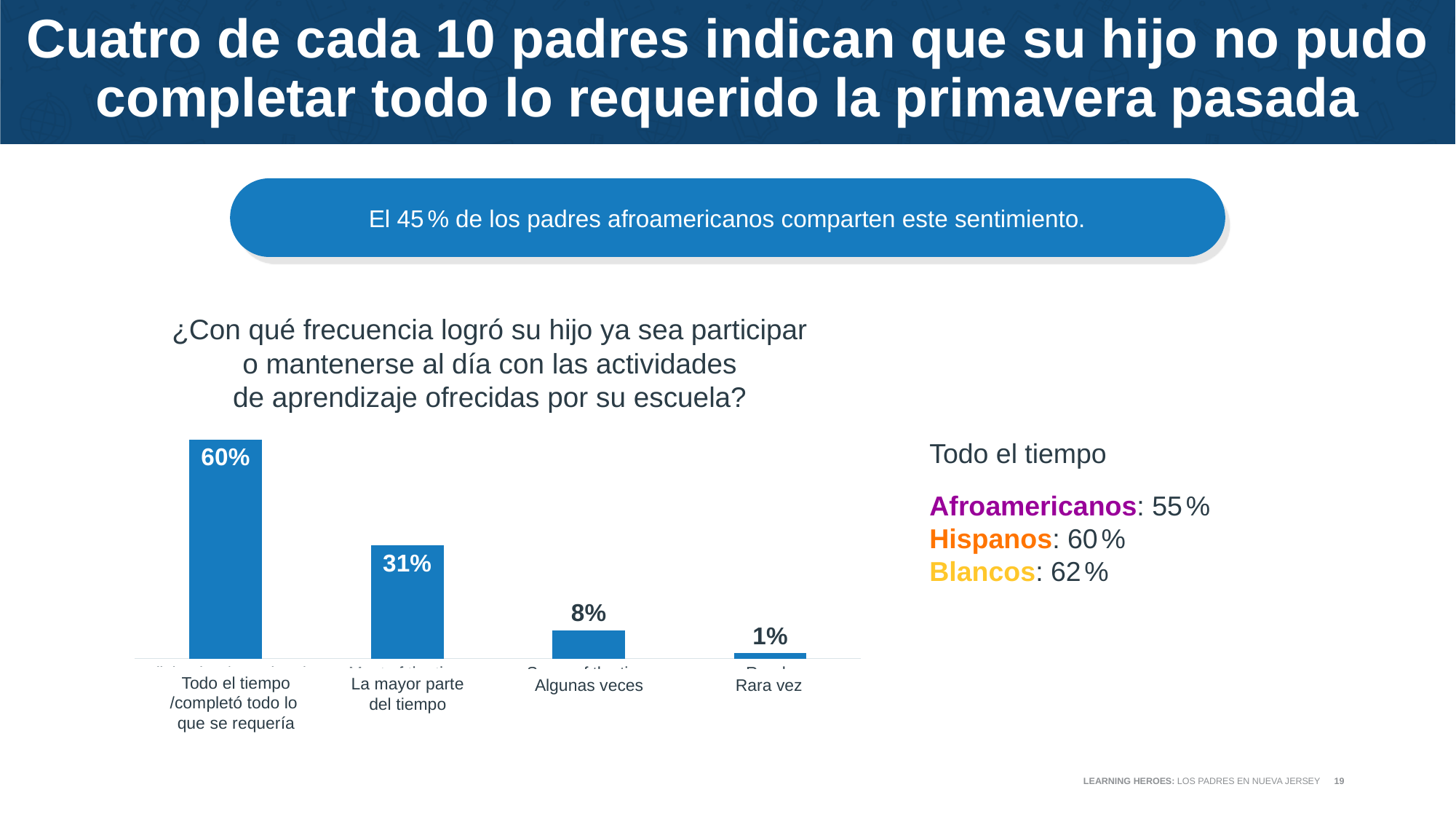
What is the difference between the values for 'Todo el tiempo /completó todo lo que se requería' and 'La mayor parte del tiempo'? 29% Which category has the lowest value? Rara vez What is the difference between the values for 'Algunas veces' and 'Rara vez'? 7% Do the values rise or fall from left to right across the categories? Fall What is the value for 'Algunas veces'? 8% How many categories are shown in the chart? 4 What is the value for 'Rara vez'? 1% What is the value for 'La mayor parte del tiempo'? 31% What is the value for 'Todo el tiempo /completó todo lo que se requería'? 60% Which category has the highest value? Todo el tiempo /completó todo lo que se requería What kind of chart is shown on the slide? Bar chart Which is larger, the value for 'La mayor parte del tiempo' or the value for 'Algunas veces'? La mayor parte del tiempo